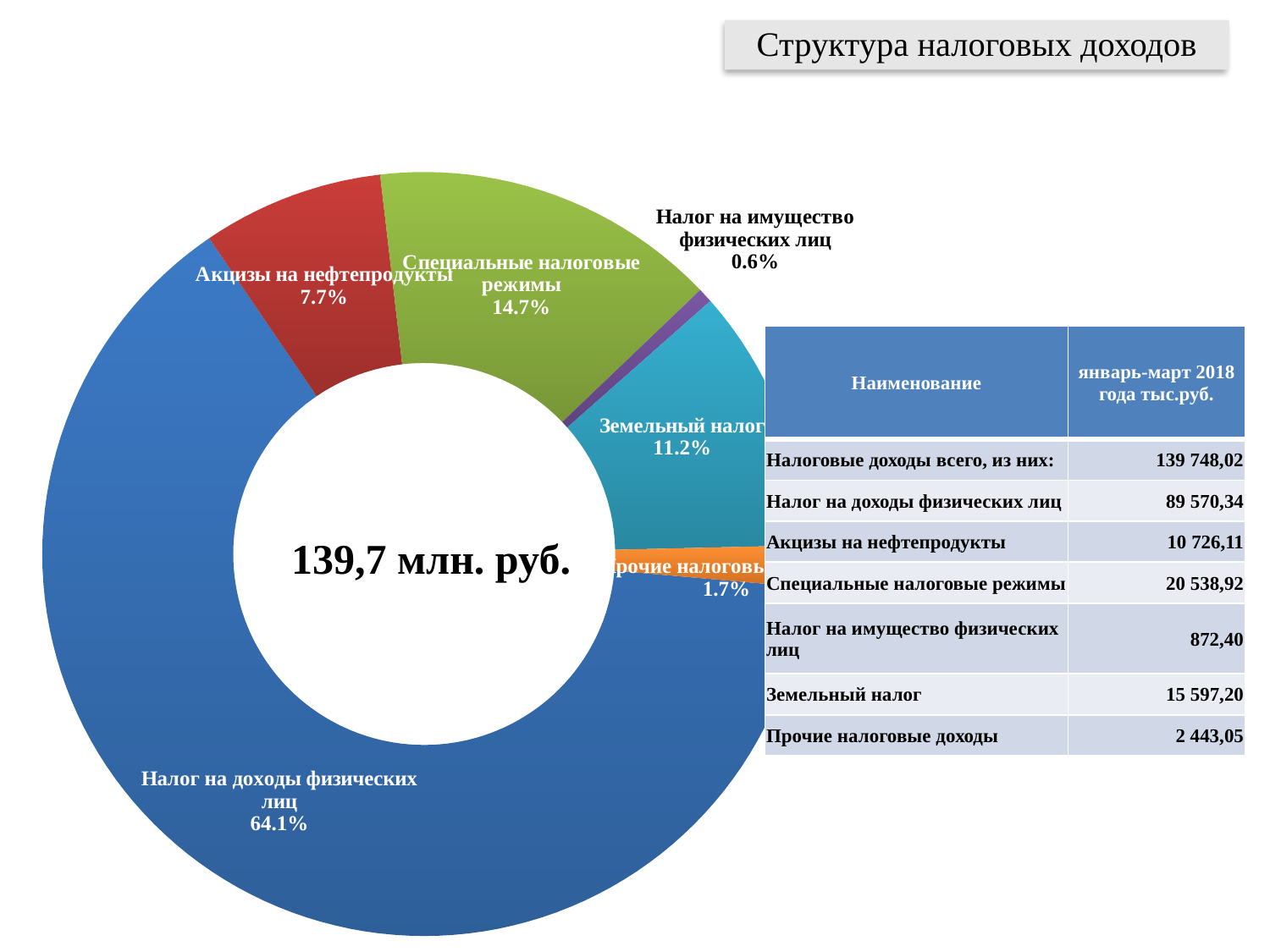
What is the difference in percentage points between Специальные налоговые режимы and Земельный налог? 3.5 Which is larger: the share for Акцизы на нефтепродукты or the share for Земельный налог? Земельный налог What percentage is shown for Налог на имущество физических лиц? 0.6% Which category has the smallest slice of the chart? Налог на имущество физических лиц What share of the pie does Налог на доходы физических лиц hold? 64.1% What percentage is shown for Земельный налог? 11.2% What percentage is shown for Акцизы на нефтепродукты? 7.7% What kind of chart is shown on the slide? Pie (doughnut) chart What total value is printed in the centre of the chart? 139,7 млн. руб. How many slices does the chart have? 6 Which category has the largest slice of the chart? Налог на доходы физических лиц What percentage is shown for Специальные налоговые режимы? 14.7%